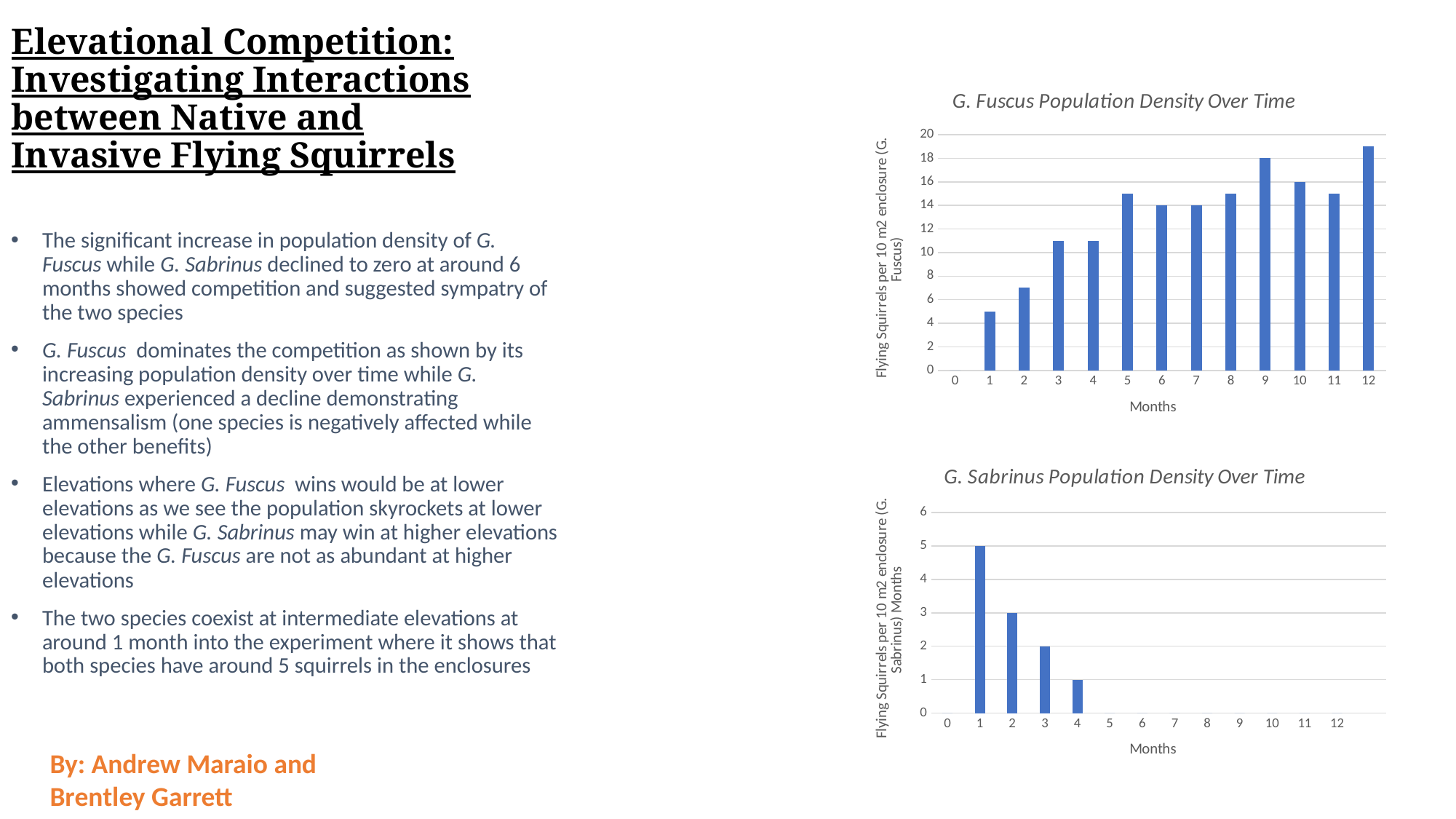
In the 'G. Sabrinus Population Density Over Time' chart, what is the value at month 4? 1 In the 'G. Fuscus Population Density Over Time' chart, which month has the lowest value? 0 In the 'G. Fuscus Population Density Over Time' chart, is the value for month 12 greater or less than 18? greater In the 'G. Fuscus Population Density Over Time' chart, do the values generally rise or fall from month 1 to month 12? rise In the 'G. Sabrinus Population Density Over Time' chart, do the values rise or fall from month 1 to month 4? fall In the 'G. Fuscus Population Density Over Time' chart, what is the value at month 10? 16 In the 'G. Sabrinus Population Density Over Time' chart, how many months have a visible bar? 4 In the 'G. Sabrinus Population Density Over Time' chart, what is the difference between the values at month 1 and month 3? 3 In the 'G. Sabrinus Population Density Over Time' chart, what is the value at month 1? 5 What kind of chart is the 'G. Fuscus Population Density Over Time' chart? bar chart In the 'G. Sabrinus Population Density Over Time' chart, which month has the highest value? 1 In the 'G. Fuscus Population Density Over Time' chart, which month has the highest value? 12